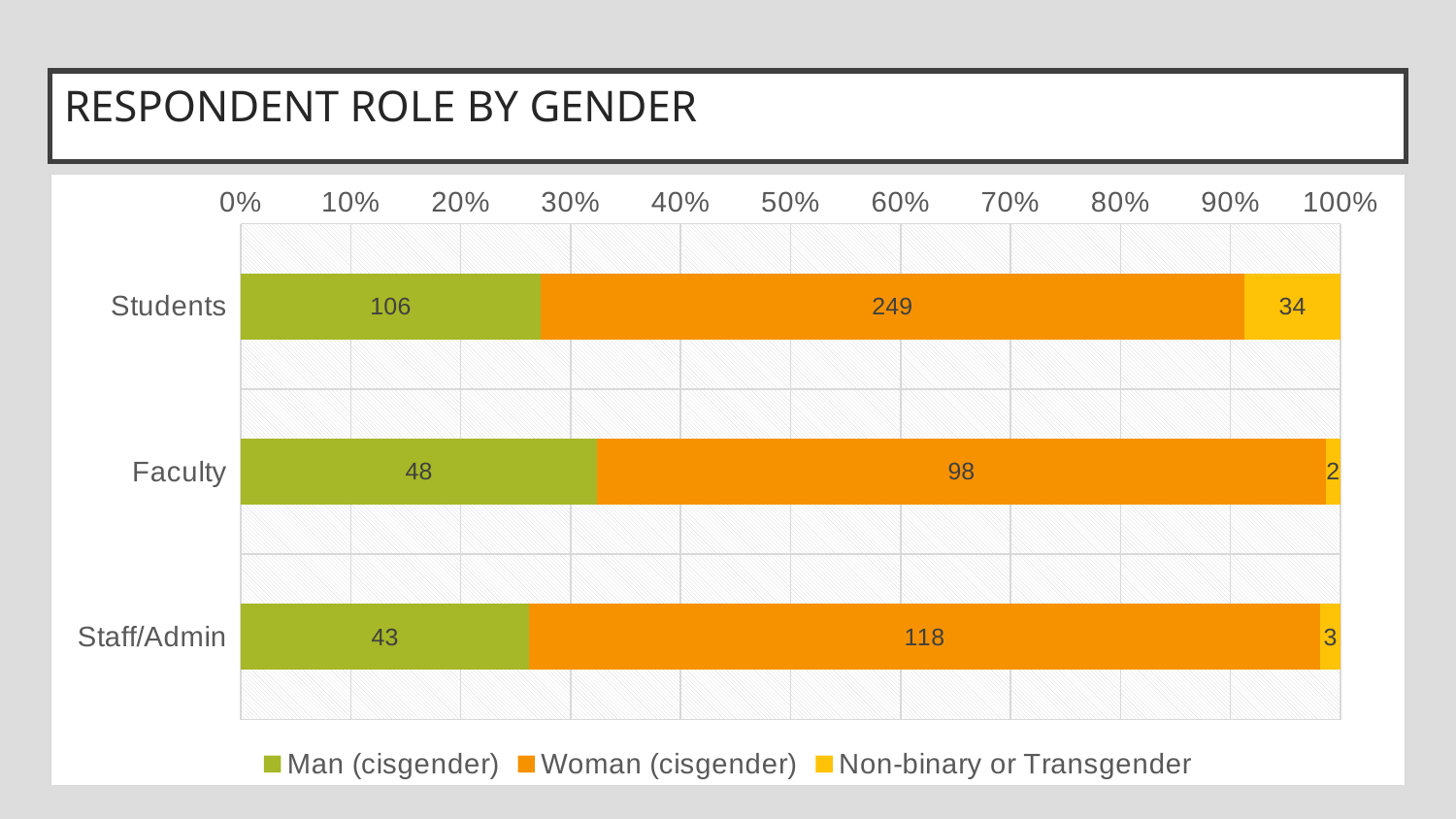
What is the value for Non-binary or Transgender among Staff/Admin? 3 Is the Man (cisgender) share of the Students bar greater or less than 30%? less Which is larger: the Woman (cisgender) count for Faculty or for Staff/Admin? Staff/Admin What is the value for Woman (cisgender) among Students? 249 What is the difference between the Man (cisgender) counts for Students and Faculty? 58 How many roles are shown on the chart? 3 How many series does the legend list? 3 Which role has the highest Woman (cisgender) count? Students What is the value for Man (cisgender) among Faculty? 48 What is the total number of Faculty respondents across all three gender categories? 148 Which role has the lowest Non-binary or Transgender count? Faculty What kind of chart is shown? Stacked bar chart